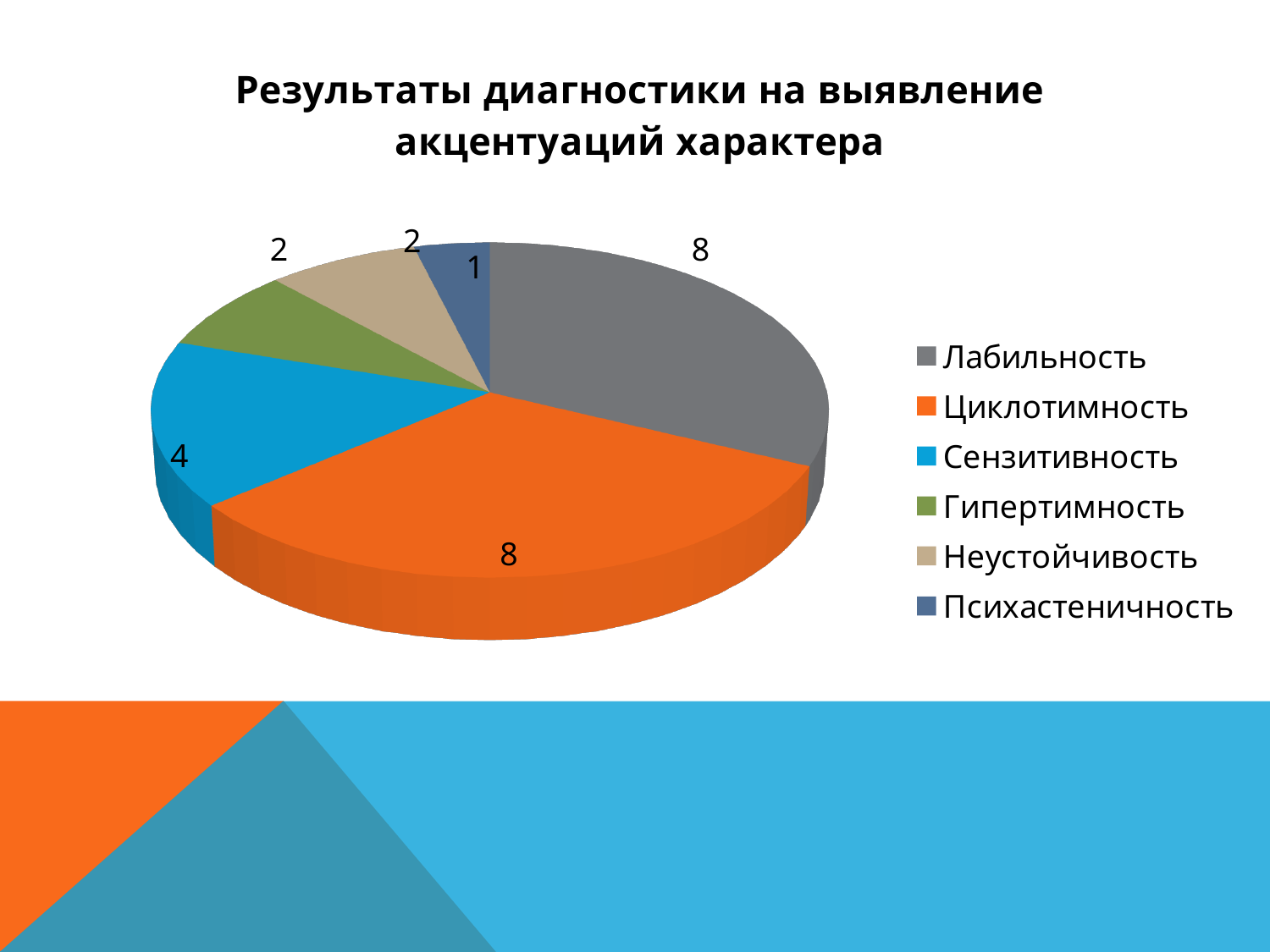
What share of the pie does Сензитивность represent? 16% What is the value for Сензитивность? 4 What is the total of all the slices in the pie chart? 25 What kind of chart is shown on the slide? Pie chart What is the value for Гипертимность? 2 What is the value for Психастеничность? 1 What is the title of the chart? Результаты диагностики на выявление акцентуаций характера Which is larger, the value for Сензитивность or the value for Неустойчивость? Сензитивность What is the value for Циклотимность? 8 Which category has the smallest slice? Психастеничность How many categories does the pie chart have? 6 What is the difference between the values for Лабильность and Сензитивность? 4